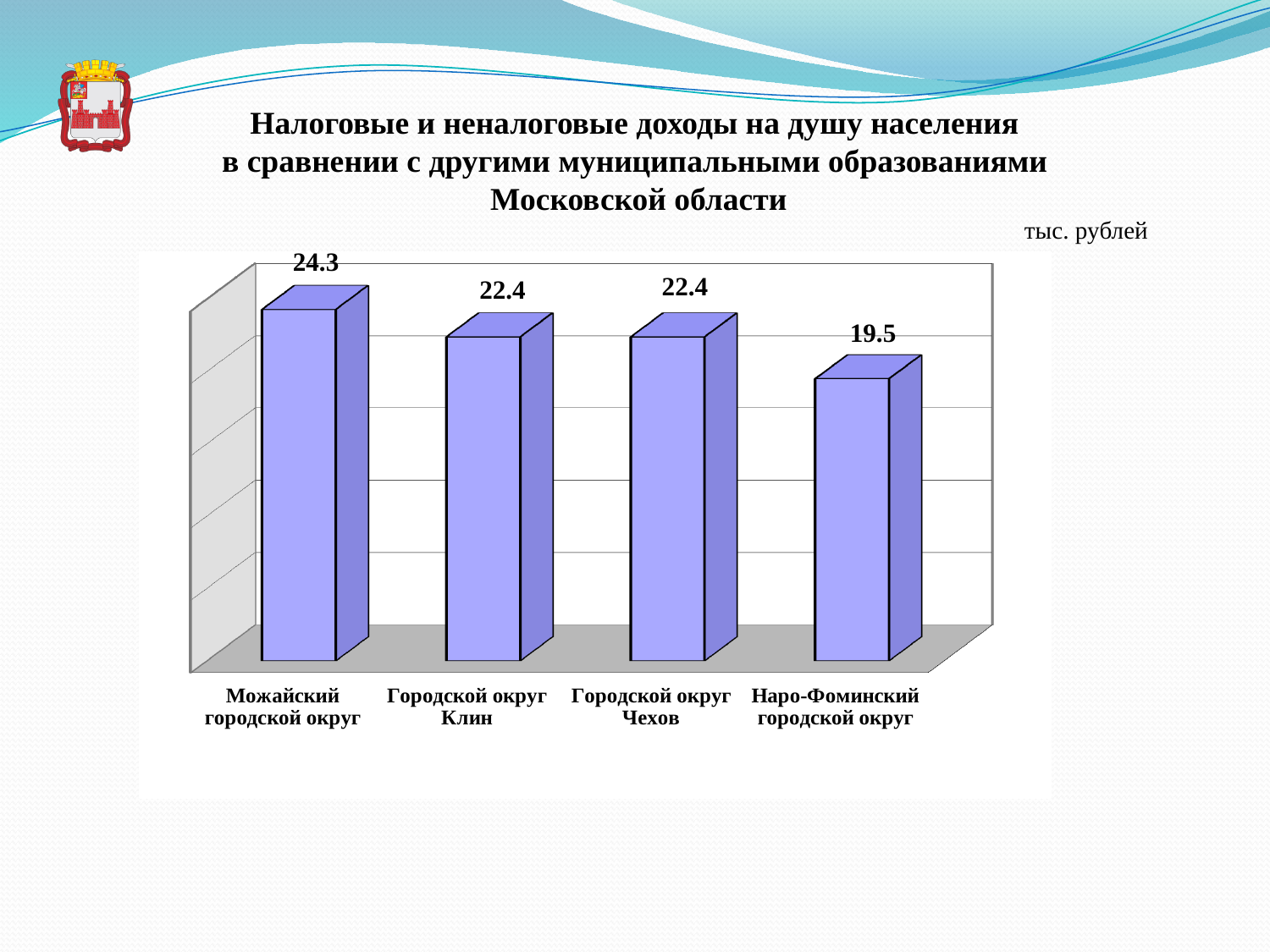
Which category has the lowest value? Наро-Фоминский городской округ What is the difference between the values for Можайский городской округ and Наро-Фоминский городской округ? 4.8 What is the value for Городской округ Клин? 22.4 What is the value for Можайский городской округ? 24.3 What unit is indicated for the values in the chart? тыс. рублей Which category has the highest value? Можайский городской округ How many categories are shown in the chart? 4 What kind of chart is shown on the slide? bar chart What is the value for Наро-Фоминский городской округ? 19.5 What is the difference between the values for Городской округ Чехов and Наро-Фоминский городской округ? 2.9 Do the values rise or fall from left to right across the categories? fall Which is larger, the value for Можайский городской округ or the value for Городской округ Клин? Можайский городской округ